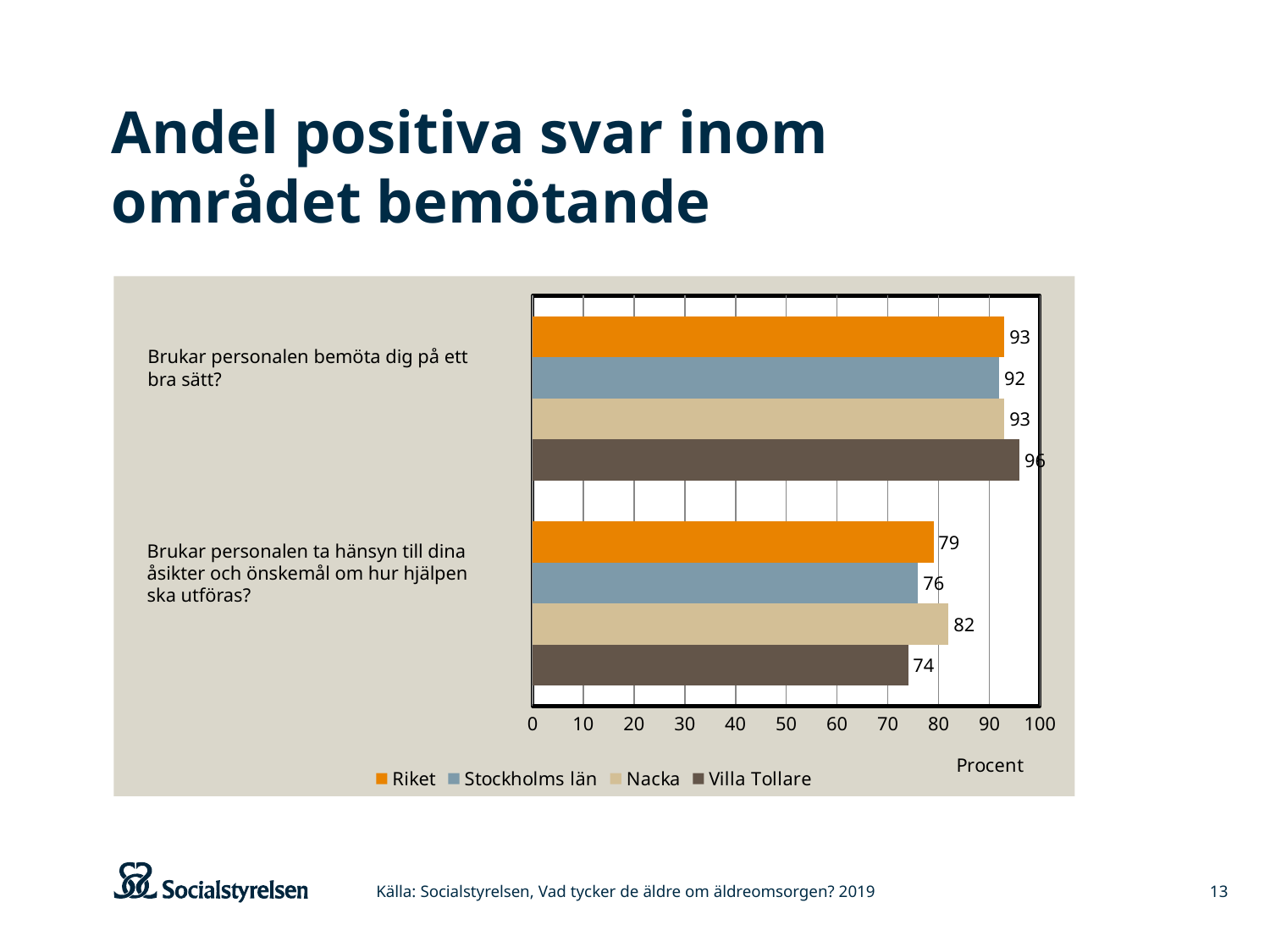
What is the label on the horizontal axis of the chart? Procent Which series has the lowest value for the question "Brukar personalen ta hänsyn till dina åsikter och önskemål om hur hjälpen ska utföras?"? Villa Tollare What is the value for Nacka for the question "Brukar personalen ta hänsyn till dina åsikter och önskemål om hur hjälpen ska utföras?"? 82 What is the value for Riket for the question "Brukar personalen bemöta dig på ett bra sätt?"? 93 Which series has the highest value for the question "Brukar personalen bemöta dig på ett bra sätt?"? Villa Tollare What is the value for Villa Tollare for the question "Brukar personalen bemöta dig på ett bra sätt?"? 96 Which is larger for the question "Brukar personalen ta hänsyn till dina åsikter och önskemål om hur hjälpen ska utföras?": the value for Riket or the value for Stockholms län? Riket How many series does the legend list? 4 How many question categories are shown on the chart? 2 What is the difference between the Nacka and Villa Tollare values for the question "Brukar personalen ta hänsyn till dina åsikter och önskemål om hur hjälpen ska utföras?"? 8 What kind of chart is shown on the slide? bar chart What is the value for Stockholms län for the question "Brukar personalen ta hänsyn till dina åsikter och önskemål om hur hjälpen ska utföras?"? 76